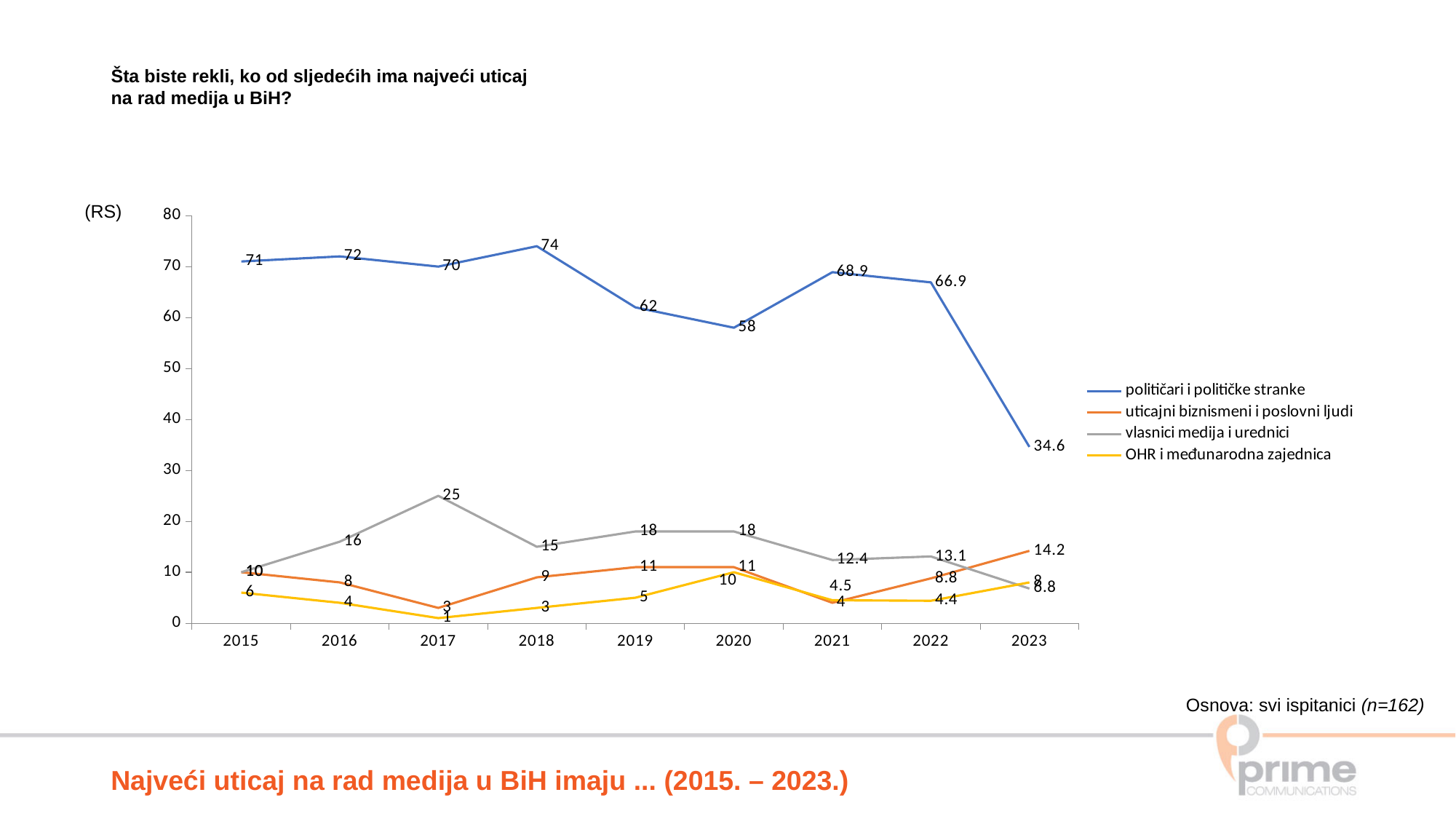
What is the value for 'uticajni biznismeni i poslovni ljudi' in 2023? 14.2 What is the value for 'političari i političke stranke' in 2023? 34.6 In which year does 'političari i političke stranke' reach its highest value? 2018 What is the value for 'vlasnici medija i urednici' in 2017? 25 In which year does 'političari i političke stranke' have its lowest value? 2023 What is the difference between the 2022 and 2023 values for 'političari i političke stranke'? 32.3 How many series does the legend list? 4 What kind of chart is shown on the slide? line chart What is the value for 'OHR i međunarodna zajednica' in 2020? 10 In 2020, which is larger: 'vlasnici medija i urednici' or 'uticajni biznismeni i poslovni ljudi'? vlasnici medija i urednici Does the value for 'OHR i međunarodna zajednica' rise or fall from 2015 to 2017? fall How many years are shown on the x axis? 9